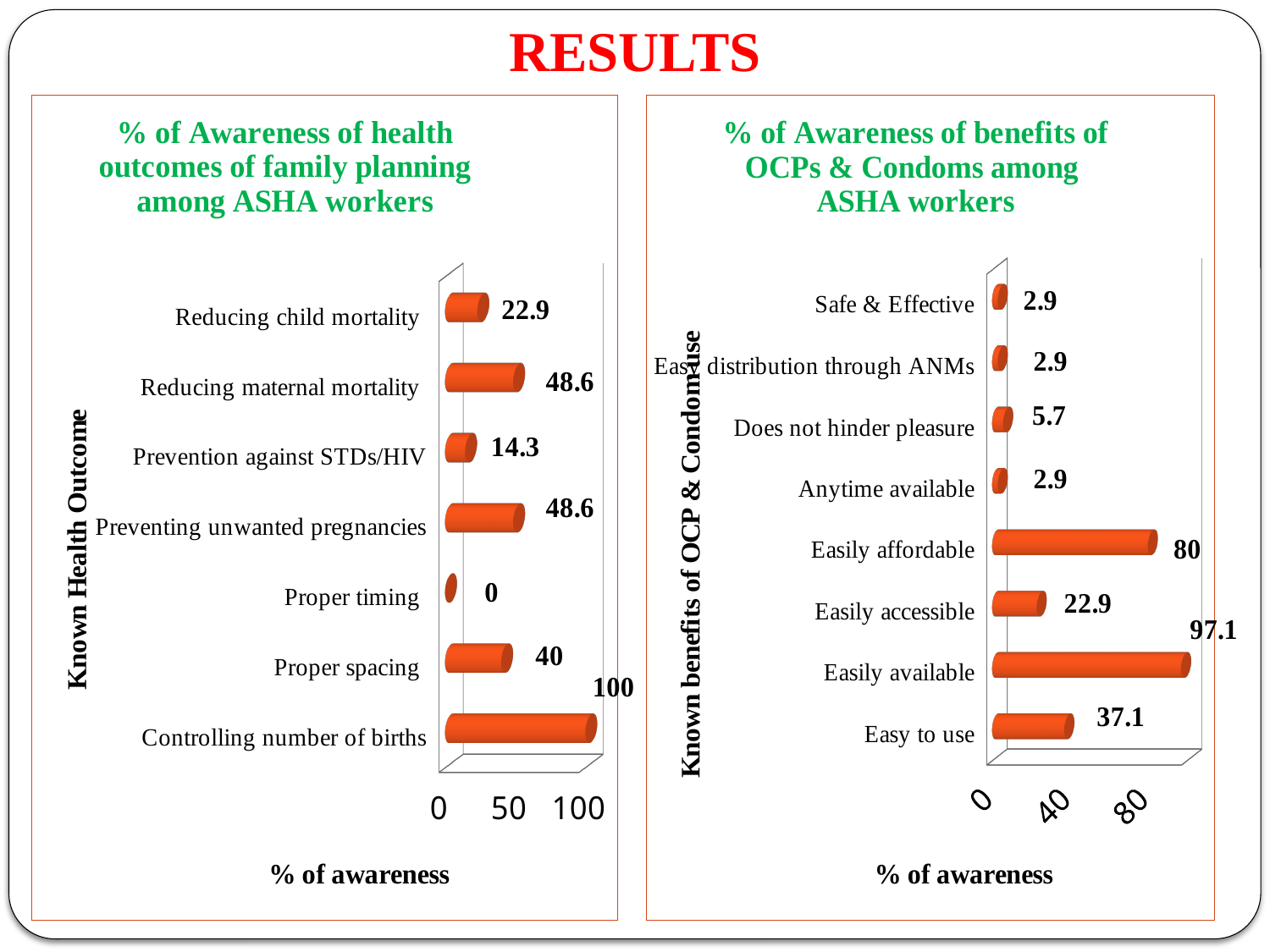
In the left chart (% of Awareness of health outcomes of family planning among ASHA workers), how many health outcome categories are shown? 7 In the left chart (% of Awareness of health outcomes of family planning among ASHA workers), which health outcome has the highest % of awareness? Controlling number of births In the left chart (% of Awareness of health outcomes of family planning among ASHA workers), what is the difference between the values for Proper spacing and Prevention against STDs/HIV? 25.7 What is the label on the x axis of the right chart (% of Awareness of benefits of OCPs & Condoms among ASHA workers)? % of awareness In the right chart (% of Awareness of benefits of OCPs & Condoms among ASHA workers), how many benefit categories are shown? 8 In the right chart (% of Awareness of benefits of OCPs & Condoms among ASHA workers), what is the value for Easily affordable? 80 In the right chart (% of Awareness of benefits of OCPs & Condoms among ASHA workers), which benefit has the highest % of awareness? Easily available In the right chart (% of Awareness of benefits of OCPs & Condoms among ASHA workers), what is the difference between the values for Easily available and Easily affordable? 17.1 In the left chart (% of Awareness of health outcomes of family planning among ASHA workers), which health outcome has the lowest % of awareness? Proper timing In the left chart (% of Awareness of health outcomes of family planning among ASHA workers), what kind of chart is used? Bar chart In the left chart (% of Awareness of health outcomes of family planning among ASHA workers), what is the value for Reducing maternal mortality? 48.6 In the right chart (% of Awareness of benefits of OCPs & Condoms among ASHA workers), which is larger, the value for Easy to use or the value for Easily accessible? Easy to use